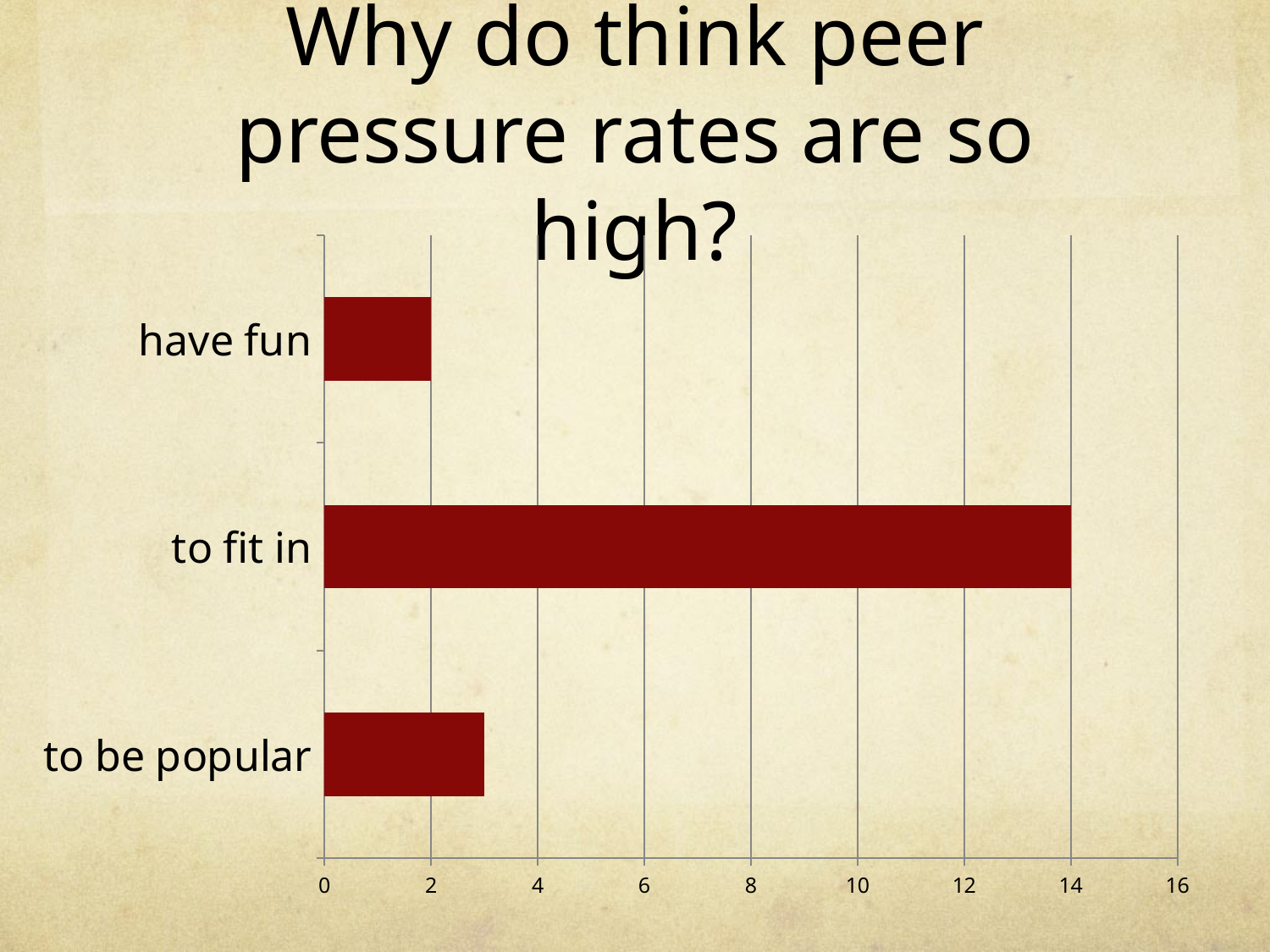
Is the value for "to be popular" greater or less than 4? less What is the title of the chart? Why do think peer pressure rates are so high? Is the value for "to be popular" greater or less than 2? greater Which category has the lowest value? have fun Which is larger, the value for "to fit in" or the value for "to be popular"? to fit in Which category has the highest value? to fit in Which is larger, the value for "to be popular" or the value for "have fun"? to be popular What is the value for "have fun"? 2 What kind of chart is shown on the slide? bar chart How many categories are shown in the chart? 3 What is the value for "to fit in"? 14 What is the difference between the values for "to fit in" and "have fun"? 12